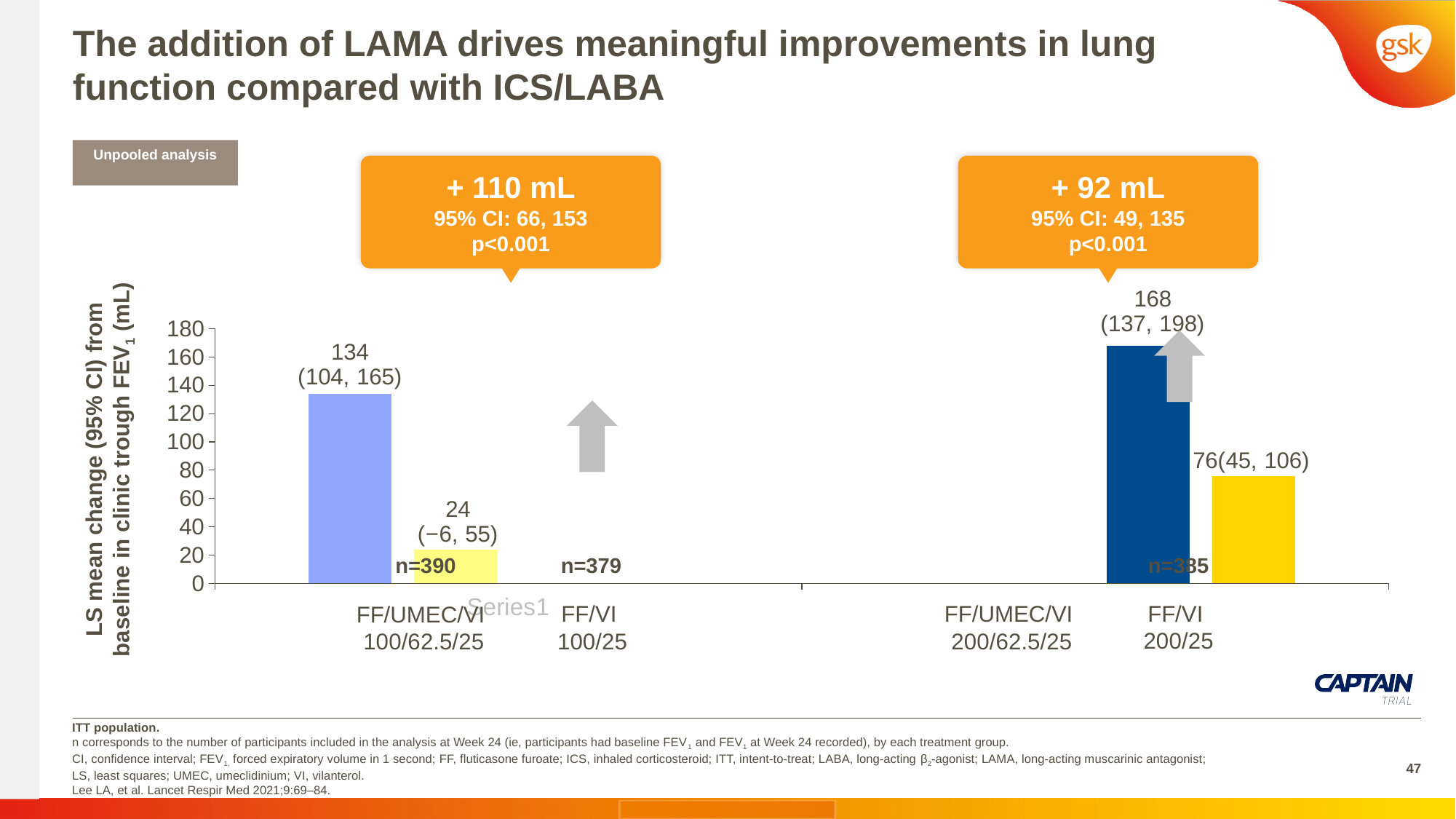
What is the LS mean change from baseline in trough FEV1 for FF/UMEC/VI 100/62.5/25? 134 What treatment difference is shown in the callout above the 100 mcg FF dose comparison? + 110 mL What is the difference in LS mean change between FF/UMEC/VI 200/62.5/25 and FF/VI 200/25? 92 Which treatment group has the highest LS mean change from baseline in trough FEV1? FF/UMEC/VI 200/62.5/25 Which has a larger LS mean change: FF/UMEC/VI 100/62.5/25 or FF/VI 200/25? FF/UMEC/VI 100/62.5/25 What is the 95% confidence interval shown for FF/VI 200/25? (45, 106) What kind of chart is shown on the slide? Bar chart Which treatment group has the lowest LS mean change from baseline in trough FEV1? FF/VI 100/25 What is the LS mean change from baseline in trough FEV1 for FF/UMEC/VI 200/62.5/25? 168 What is the LS mean change from baseline in trough FEV1 for FF/VI 100/25? 24 What is the n value shown for the FF/VI 100/25 group? n=379 How many treatment groups (bars) are plotted in the chart? 4